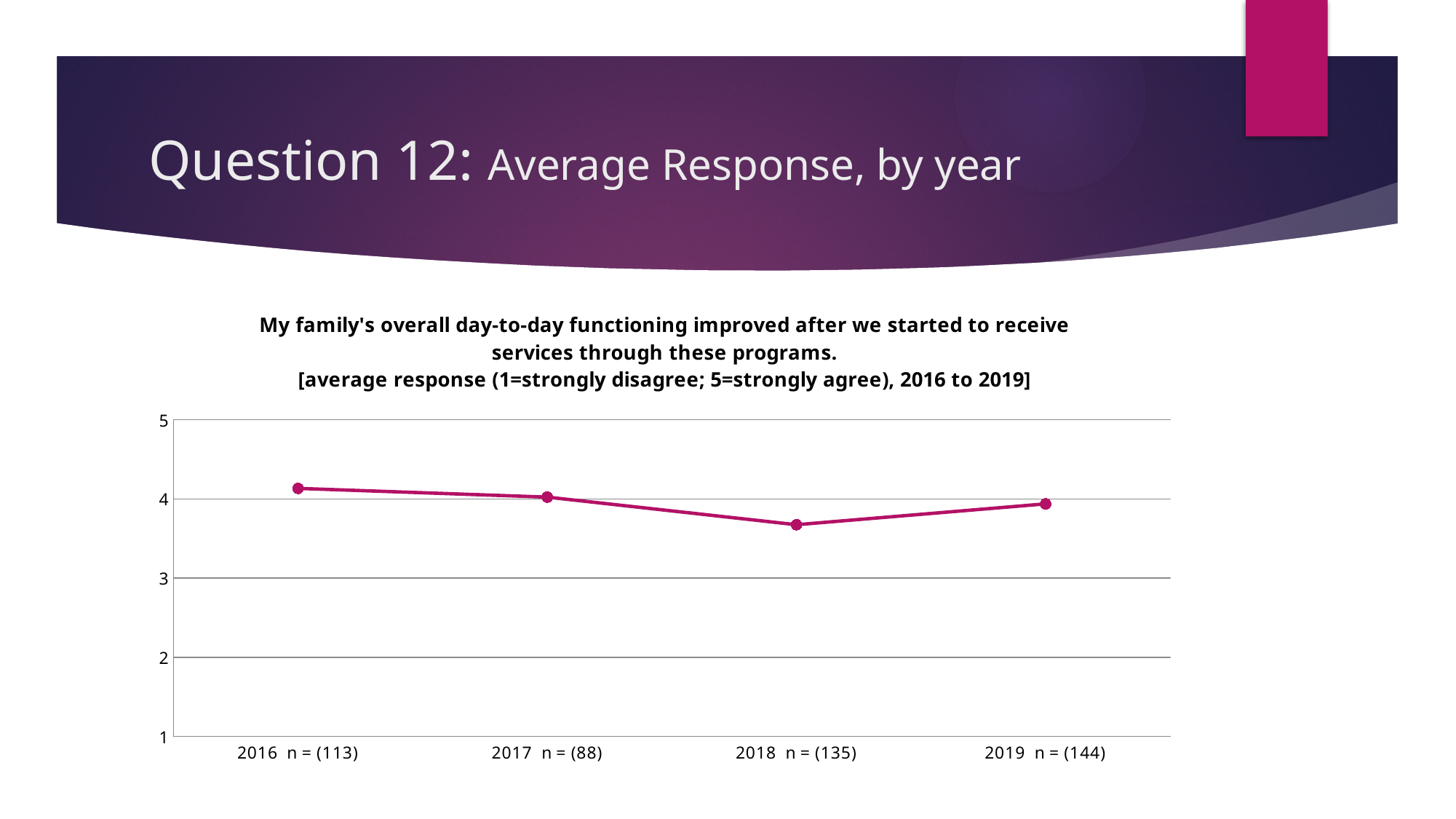
Does the average response rise or fall from 2016 to 2018? fall Is the average response for 2018 greater or less than 4? less Does the average response rise or fall from 2018 to 2019? rise How many years (data points) are plotted on the chart? 4 What is the sample size (n) shown for 2017 on the x axis? 88 Which year has the larger average response, 2016 or 2018? 2016 Which year has the lowest average response? 2018 Is the average response for 2018 greater or less than 3? greater What is the sample size (n) shown for 2019 on the x axis? 144 Which year has the highest average response? 2016 Is the average response for 2016 greater or less than 4? greater What kind of chart is shown on the slide? line chart